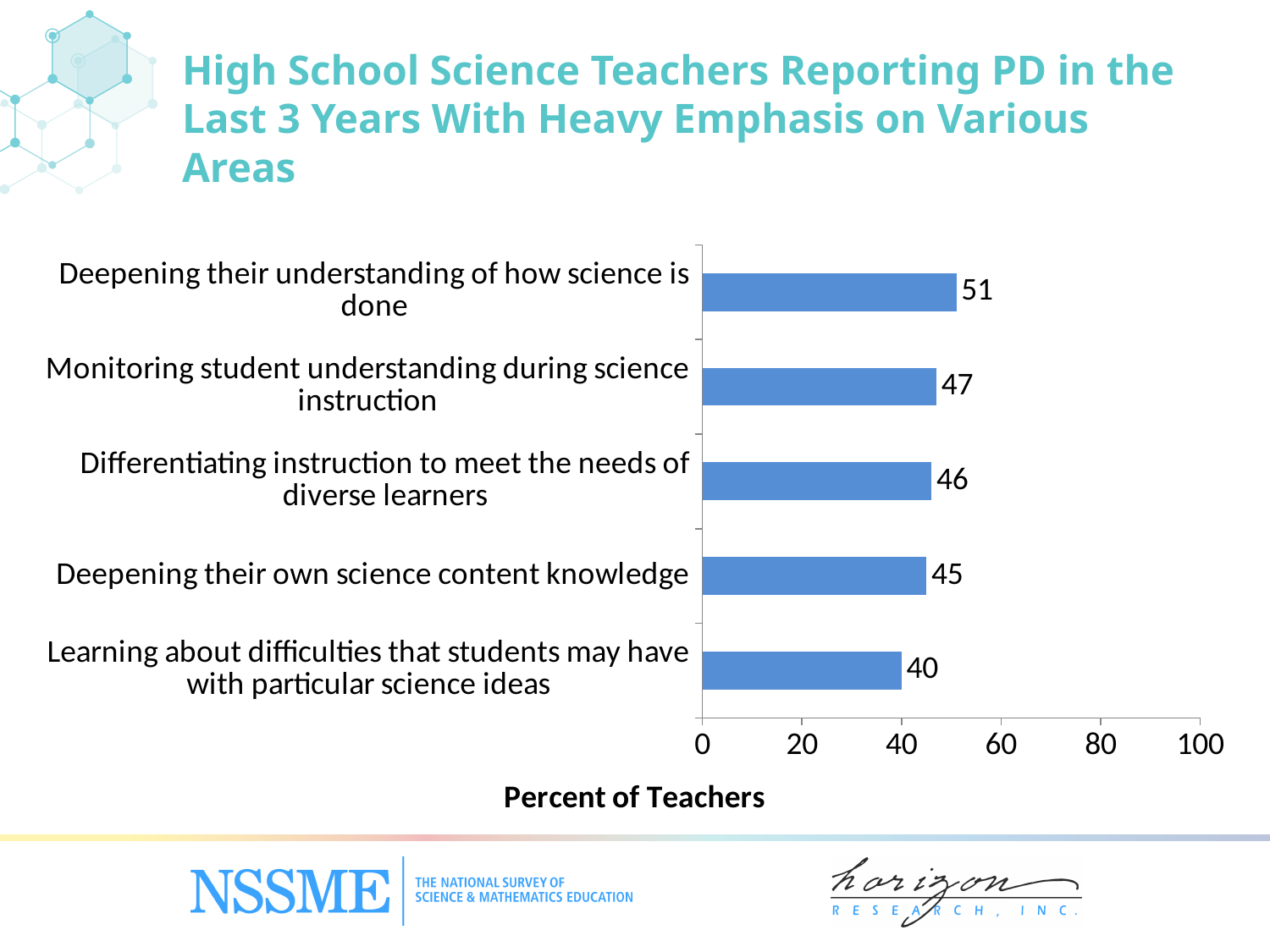
Which area has the lowest percent of teachers? Learning about difficulties that students may have with particular science ideas What is the difference between the values for 'Deepening their understanding of how science is done' and 'Learning about difficulties that students may have with particular science ideas'? 11 What percent of teachers reported PD with heavy emphasis on deepening their understanding of how science is done? 51 How many areas are shown in the chart? 5 Which is larger: the value for 'Monitoring student understanding during science instruction' or 'Learning about difficulties that students may have with particular science ideas'? Monitoring student understanding during science instruction What is the label of the horizontal axis? Percent of Teachers What is the difference between the values for 'Monitoring student understanding during science instruction' and 'Deepening their own science content knowledge'? 2 What is the value for 'Deepening their own science content knowledge'? 45 Which area has the highest percent of teachers? Deepening their understanding of how science is done What is the value for 'Learning about difficulties that students may have with particular science ideas'? 40 Is the value for 'Differentiating instruction to meet the needs of diverse learners' greater or less than 60? less What kind of chart is shown on the slide? bar chart